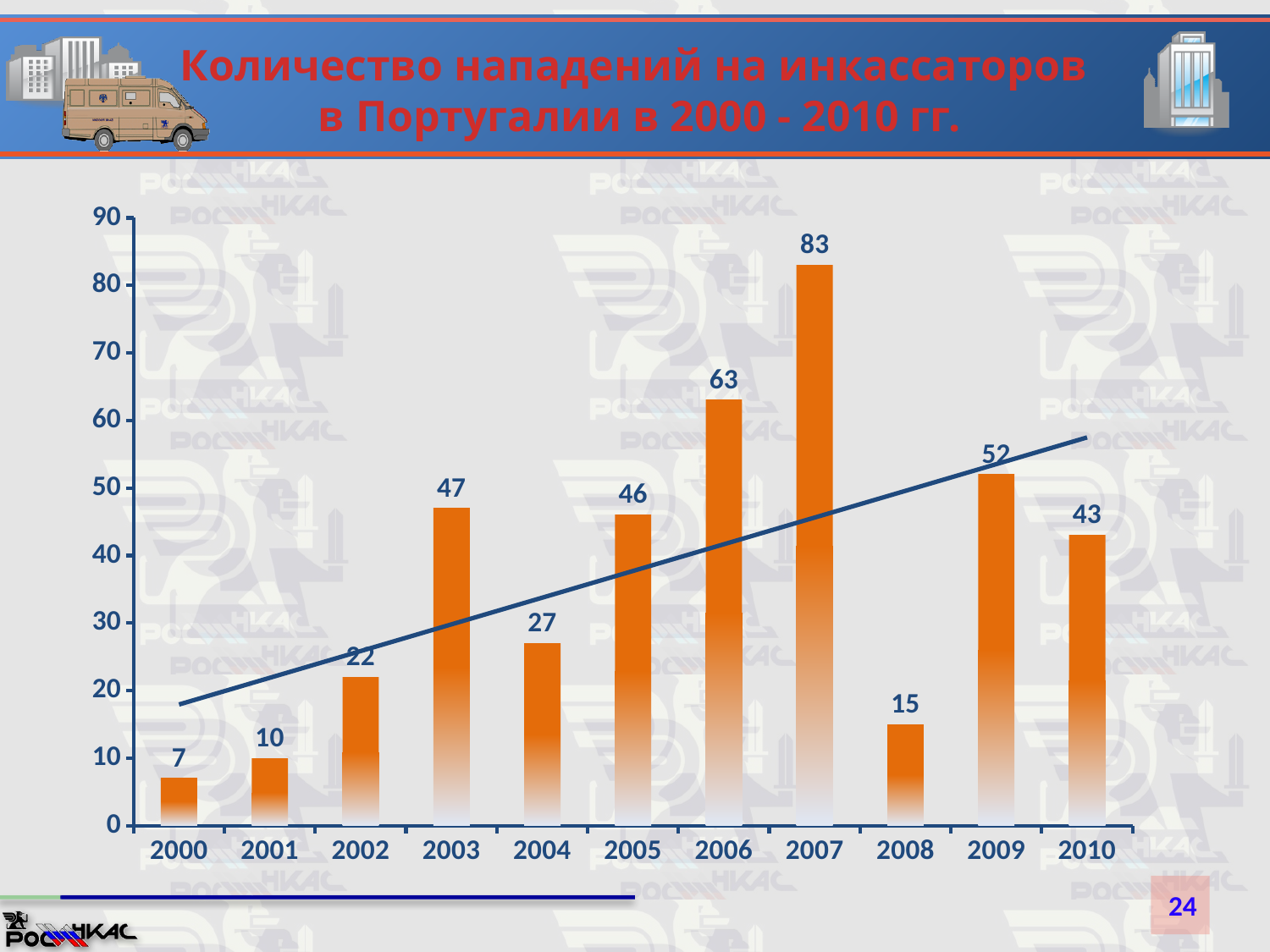
Which is larger, the value for 2010 or the value for 2009? 2009 What is the difference between the values for 2009 and 2008? 37 What is the value for 2004? 27 Which is larger, the value for 2003 or the value for 2005? 2003 Which year has the lowest value? 2000 What is the value for 2000? 7 How many years are shown on the x axis? 11 What is the difference between the values for 2007 and 2006? 20 What is the value for 2007? 83 What kind of chart is shown on the slide? bar chart What is the title of the chart? Количество нападений на инкассаторов в Португалии в 2000 - 2010 гг. Which year has the highest value? 2007